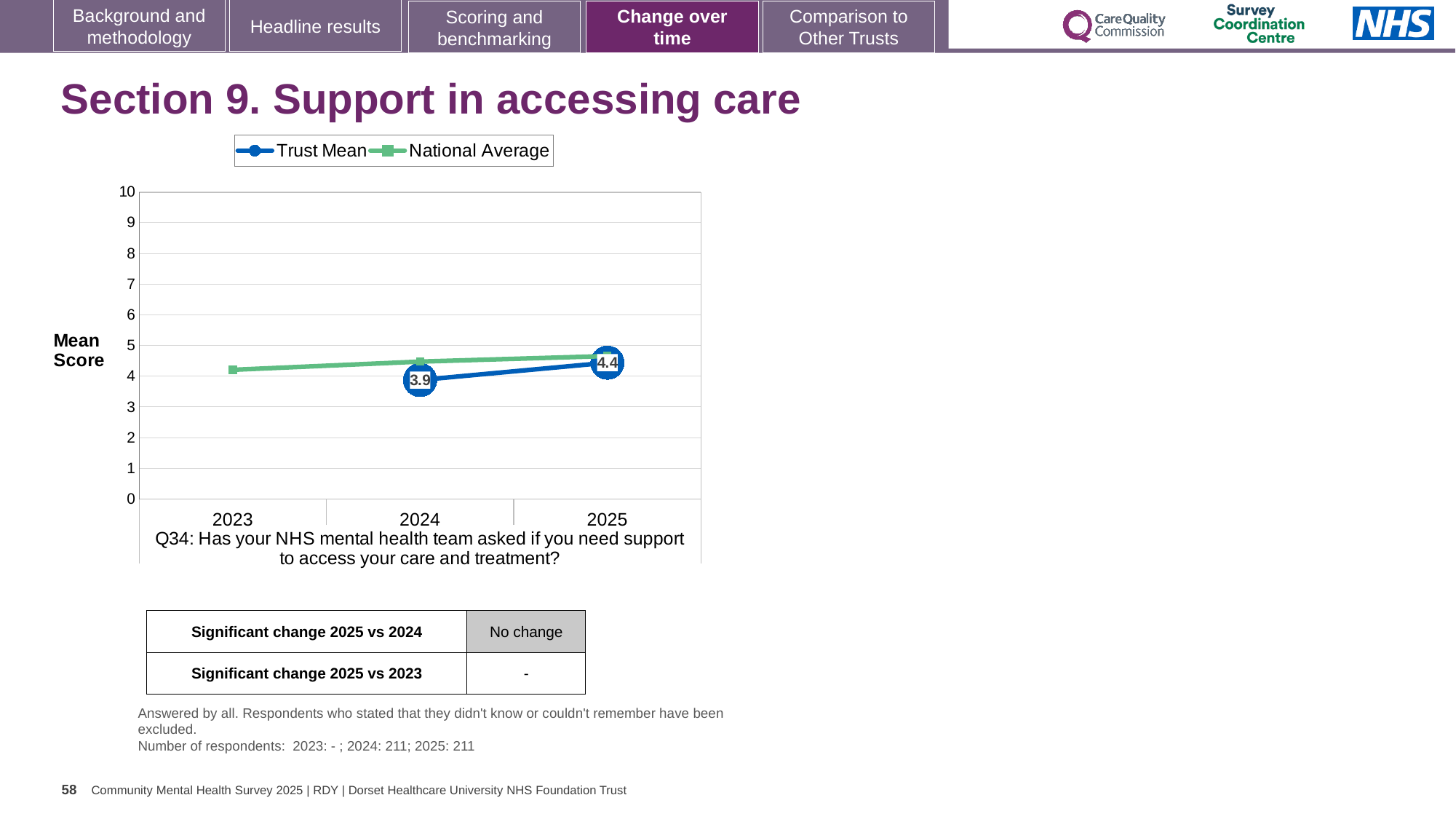
Is the National Average value for 2025 greater or less than 5? less By how much did the Trust Mean score change from 2024 to 2025? 0.5 Which year has the higher Trust Mean score, 2024 or 2025? 2025 How many years are shown on the x axis of the chart? 3 What is the label on the y axis of the chart? Mean Score Is the National Average value for 2023 greater or less than 5? less In 2024, which series has the higher value, Trust Mean or National Average? National Average How many series does the chart legend list? 2 Does the Trust Mean score rise or fall from 2024 to 2025? rise What kind of chart is shown on the slide? line chart What is the Trust Mean score for 2025? 4.4 What is the Trust Mean score for 2024? 3.9